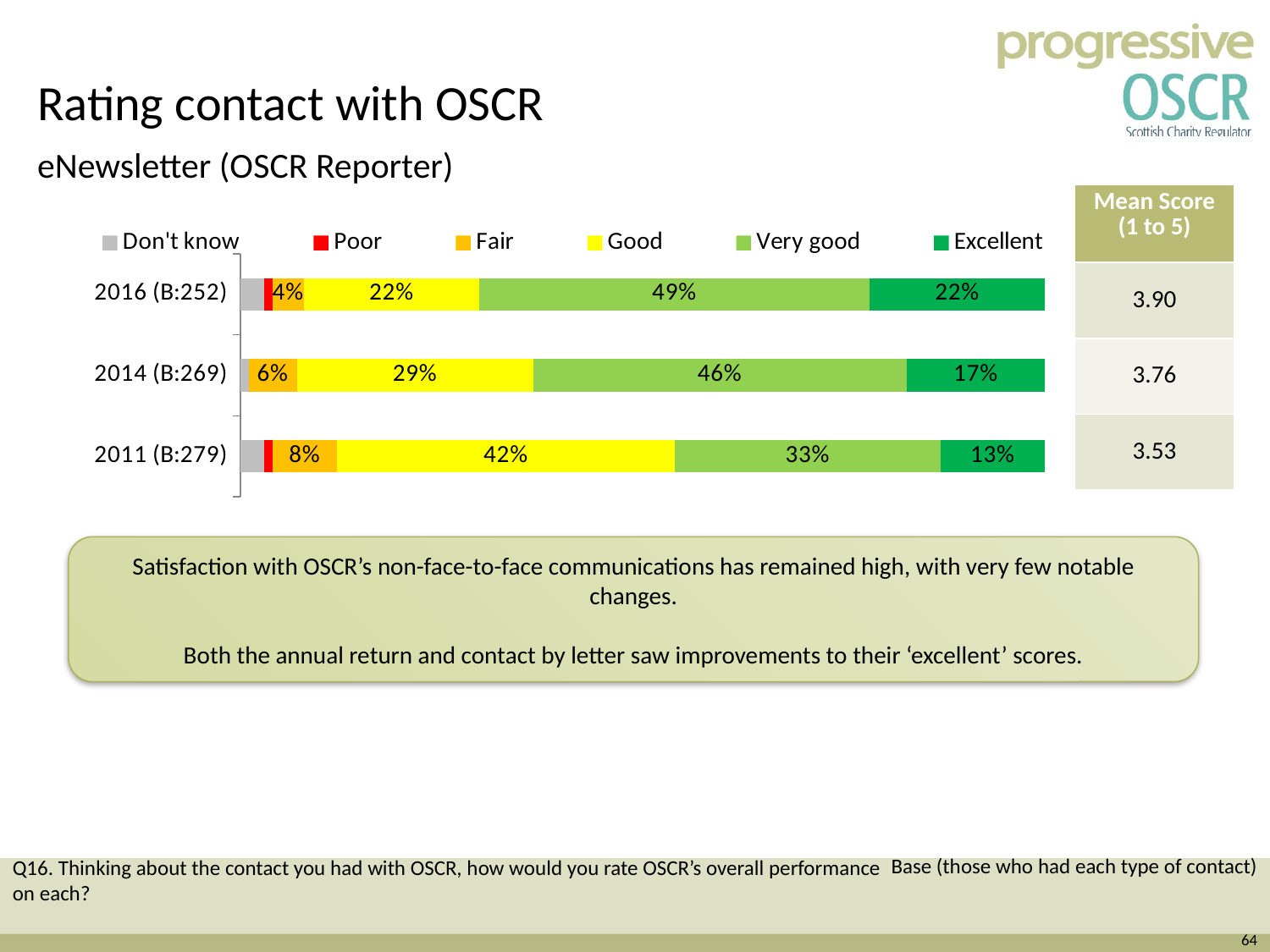
What is the 'Excellent' value for 2014 (B:269)? 17% Which is larger: the 'Very good' value for 2014 (B:269) or the 'Very good' value for 2011 (B:279)? 2014 (B:269) Does the 'Excellent' value rise or fall from 2011 to 2016? Rise Which year has the highest 'Excellent' value? 2016 (B:252) How many year categories are plotted on the chart? 3 What type of chart is shown on the slide? Stacked bar chart Which year has the lowest 'Very good' value? 2011 (B:279) What is the 'Good' value for 2011 (B:279)? 42% What is the difference between the 'Good' values for 2011 (B:279) and 2016 (B:252)? 20% How many series does the legend list? 6 What is the 'Fair' value for 2014 (B:269)? 6% What is the 'Very good' value for 2016 (B:252)? 49%